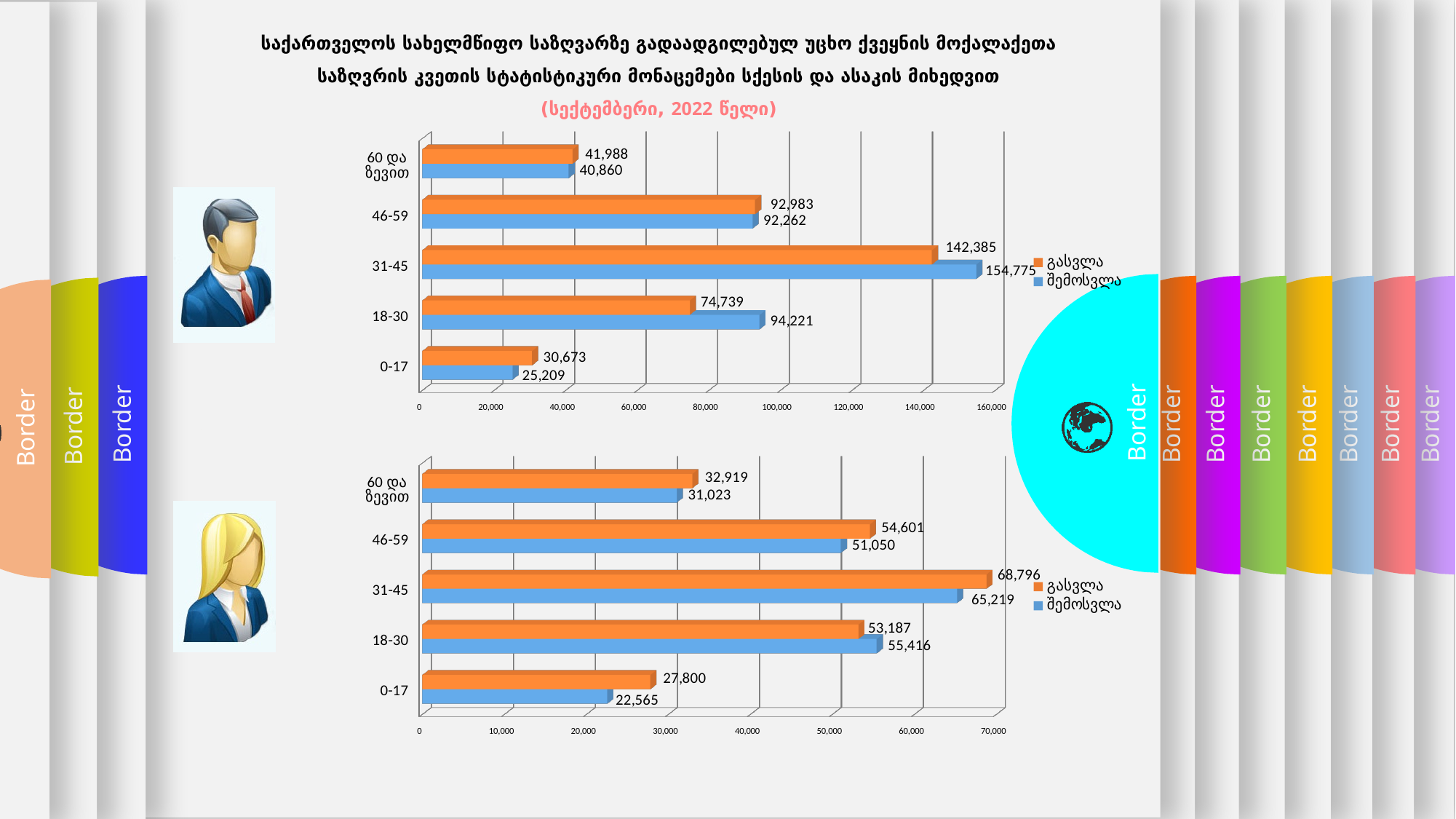
In the top chart, what is the გასვლა value for the 31-45 age group? 142,385 In the bottom chart, which age group has the highest შემოსვლა value? 31-45 In the bottom chart, what is the difference between the გასვლა and შემოსვლა values for the 46-59 age group? 3,551 In the top chart, what is the შემოსვლა value for the 18-30 age group? 94,221 In the bottom chart, what is the გასვლა value for the 0-17 age group? 27,800 In the bottom chart, which is larger for the 18-30 age group, გასვლა or შემოსვლა? შემოსვლა In the top chart, is the გასვლა value for the 18-30 age group greater or less than 80,000? less What type of chart is the bottom chart? bar chart How many age groups are shown in the bottom chart? 5 In the top chart, what is the difference between the შემოსვლა and გასვლა values for the 31-45 age group? 12,390 In the top chart, which age group has the lowest შემოსვლა value? 0-17 How many series does the legend of the top chart list? 2